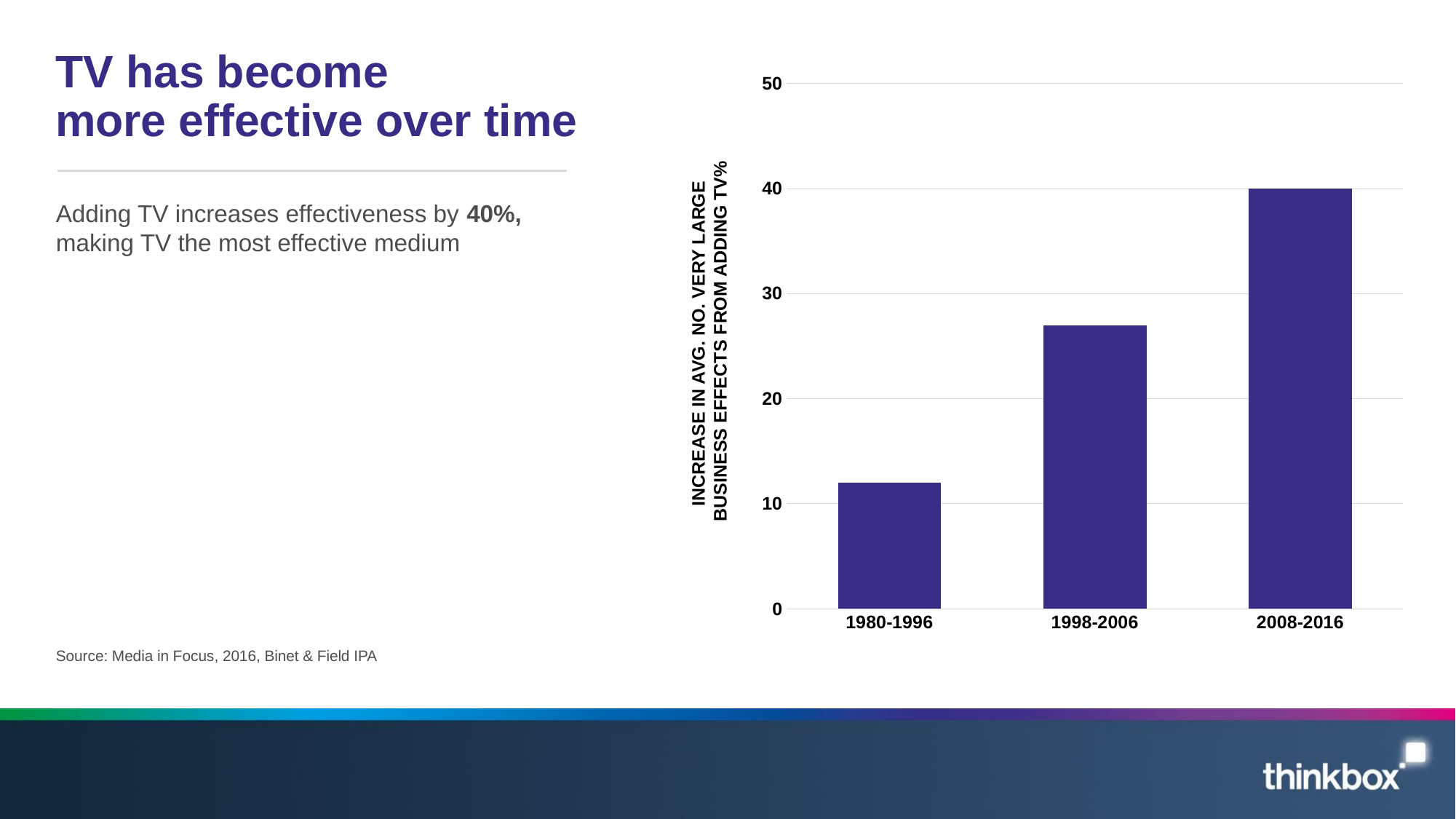
Is the value for 1980-1996 greater or less than 10? greater Is the value for 1998-2006 greater or less than 30? less How many time periods are shown on the x axis of the chart? 3 Is the value for 1998-2006 greater or less than 20? greater Which is larger, the value for 1998-2006 or the value for 1980-1996? 1998-2006 What type of chart is shown on the slide? bar chart What is the label on the vertical axis of the chart? INCREASE IN AVG. NO. VERY LARGE BUSINESS EFFECTS FROM ADDING TV% Which period has the highest bar in the chart? 2008-2016 Which period has the lowest bar in the chart? 1980-1996 Do the values rise or fall from 1980-1996 to 2008-2016 along the x axis? rise What is the value for 2008-2016 in the chart? 40